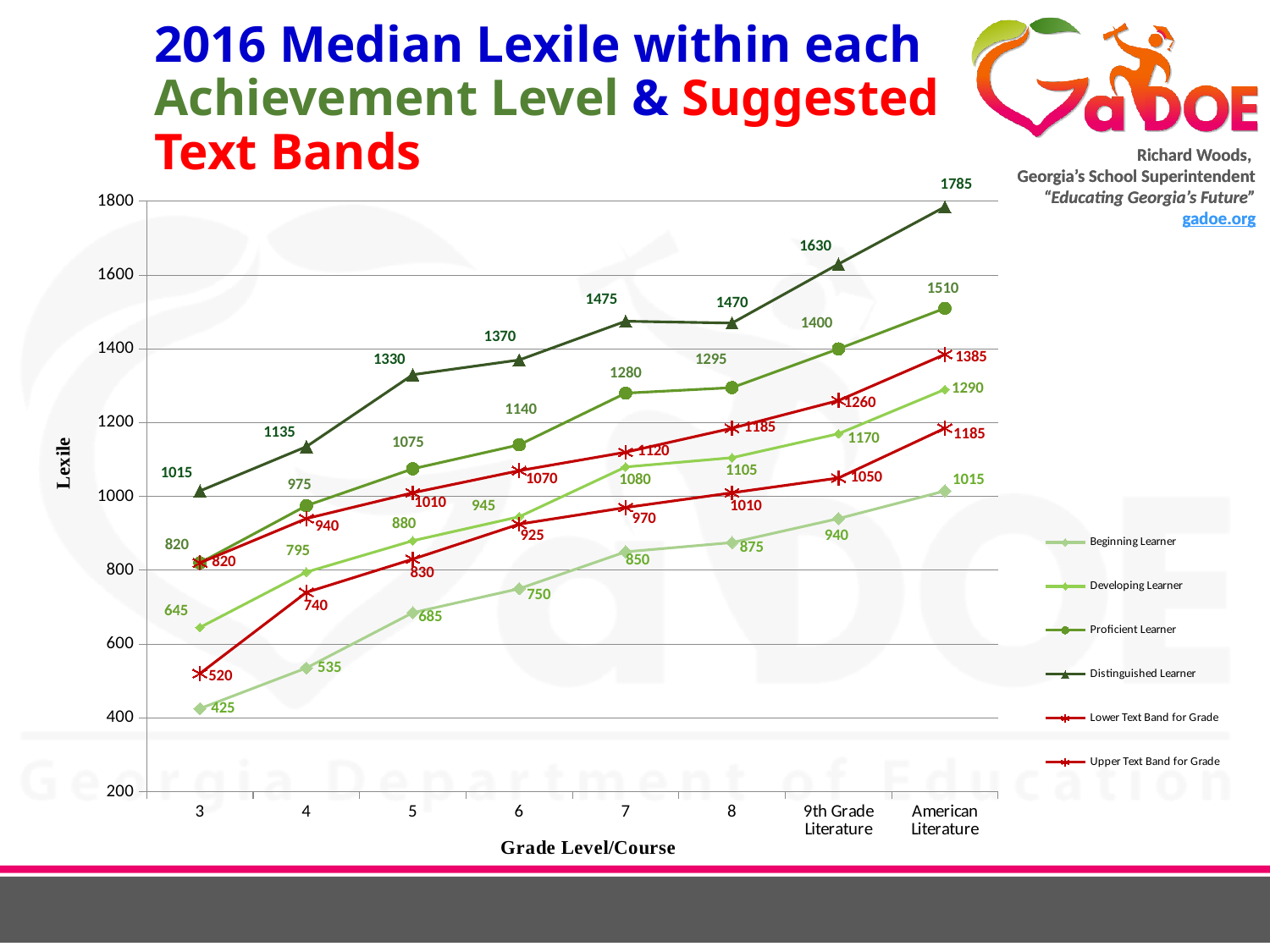
Which grade level/course has the highest Distinguished Learner median Lexile? American Literature What is the difference between the Distinguished Learner and Beginning Learner median Lexile at grade 7? 625 What is the Beginning Learner median Lexile for grade 3? 425 What is the Lower Text Band for Grade value at grade 5? 830 Which is larger at grade 6: the Developing Learner median Lexile or the Lower Text Band for Grade value? Developing Learner How many grade levels/courses are shown on the x axis? 8 What is the Distinguished Learner median Lexile for American Literature? 1785 What kind of chart is shown on the slide? Line chart Which grade level/course has the lowest Beginning Learner median Lexile? 3 How many series does the legend list? 6 What is the Upper Text Band for Grade value at grade 8? 1185 What is the Proficient Learner median Lexile for 9th Grade Literature? 1400